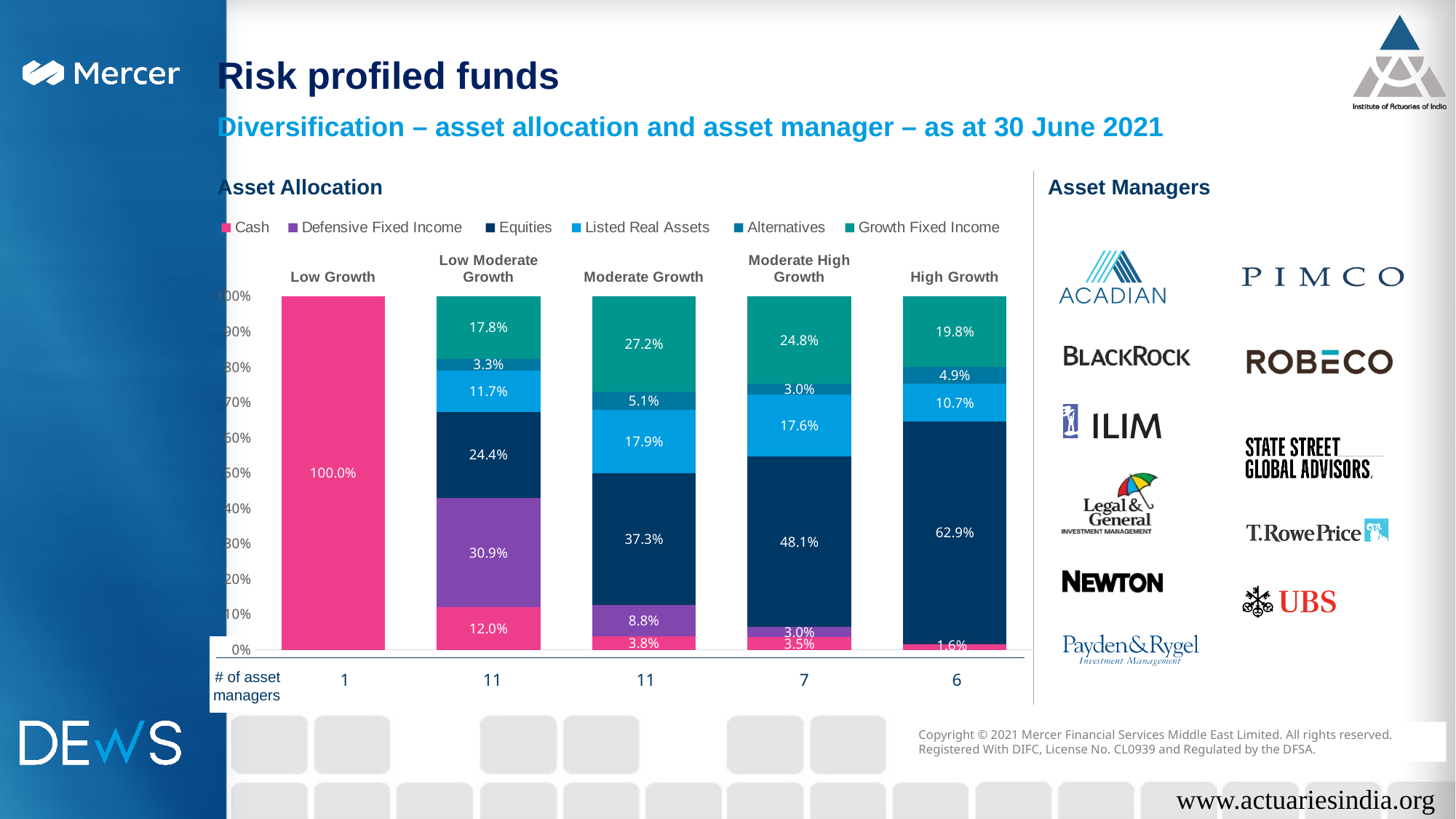
What is the difference between the Equities allocation of the Moderate High Growth fund and the Moderate Growth fund? 10.8% How many risk profile categories are plotted in the Asset Allocation chart? 5 What is the Growth Fixed Income allocation for the Moderate Growth fund? 27.2% What is the Equities allocation for the High Growth fund? 62.9% What is the Defensive Fixed Income allocation for the Low Moderate Growth fund? 30.9% What is the Cash allocation for the Low Growth fund? 100.0% Which fund has the highest Equities allocation? High Growth How many asset managers are shown for the Moderate High Growth fund? 7 Which fund has the lowest Cash allocation? High Growth Which is larger: the Listed Real Assets allocation of the Moderate Growth fund or of the High Growth fund? Moderate Growth How many series does the legend of the Asset Allocation chart list? 6 What kind of chart is shown under Asset Allocation? Stacked bar chart